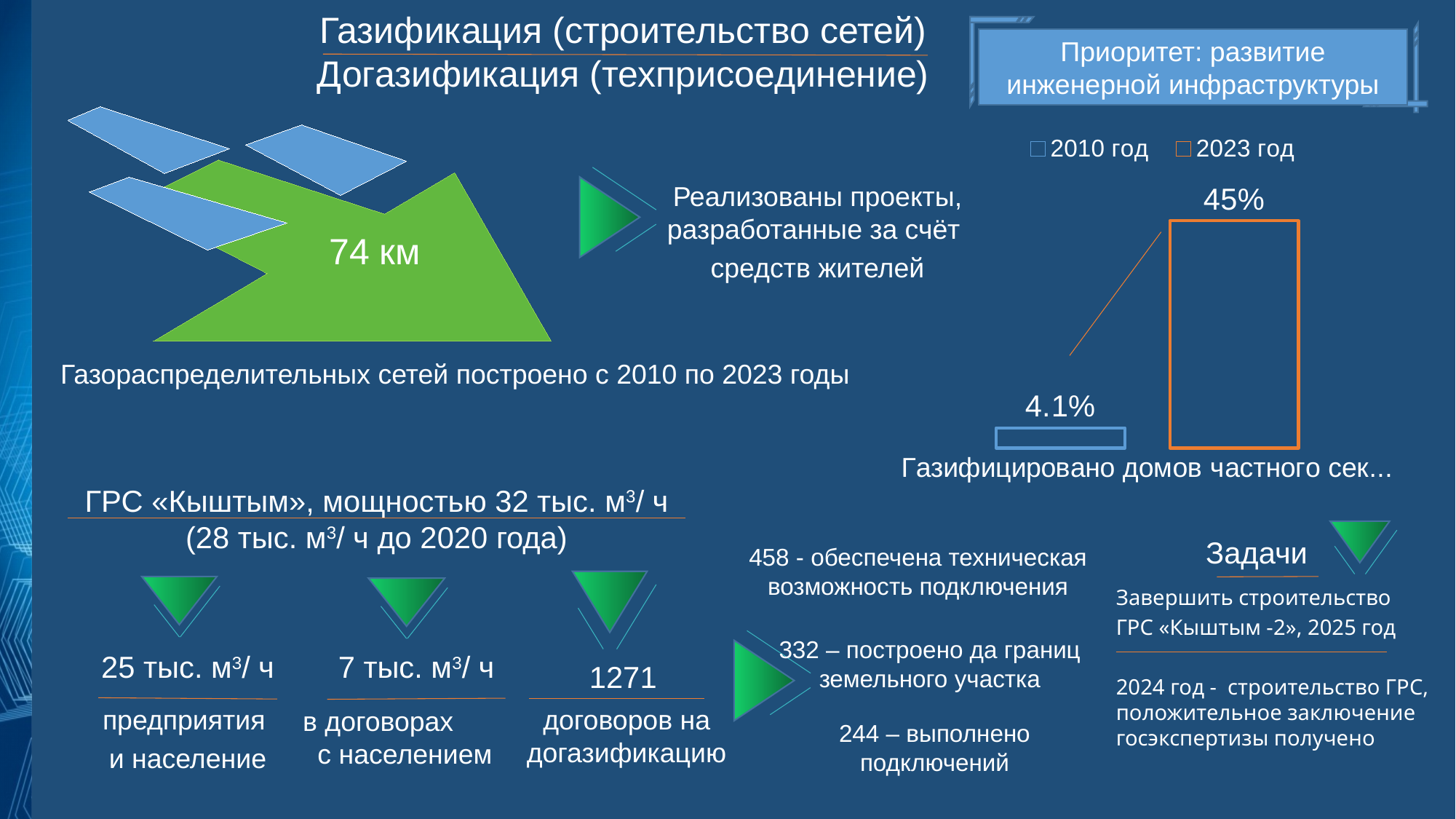
In the bar chart on the right, what is the difference between the 2023 год value and the 2010 год value? 40.9% How many series does the legend of the bar chart on the right list? 2 In the bar chart on the right, what colour is the bar for 2010 год? blue In the bar chart on the right, which year has the lower value? 2010 год In the bar chart on the right, what colour is the bar for 2023 год? orange How many bars are plotted in the bar chart on the right? 2 What kind of chart is shown on the right side of the slide under the legend '2010 год' and '2023 год'? bar chart In the bar chart on the right, what is the value for 2010 год? 4.1% In the bar chart on the right, what is the value for 2023 год? 45% In the bar chart on the right, do the values rise or fall from 2010 год to 2023 год? rise In the bar chart on the right, is the value for 2023 год larger or smaller than the value for 2010 год? larger In the bar chart on the right, which year has the higher value? 2023 год